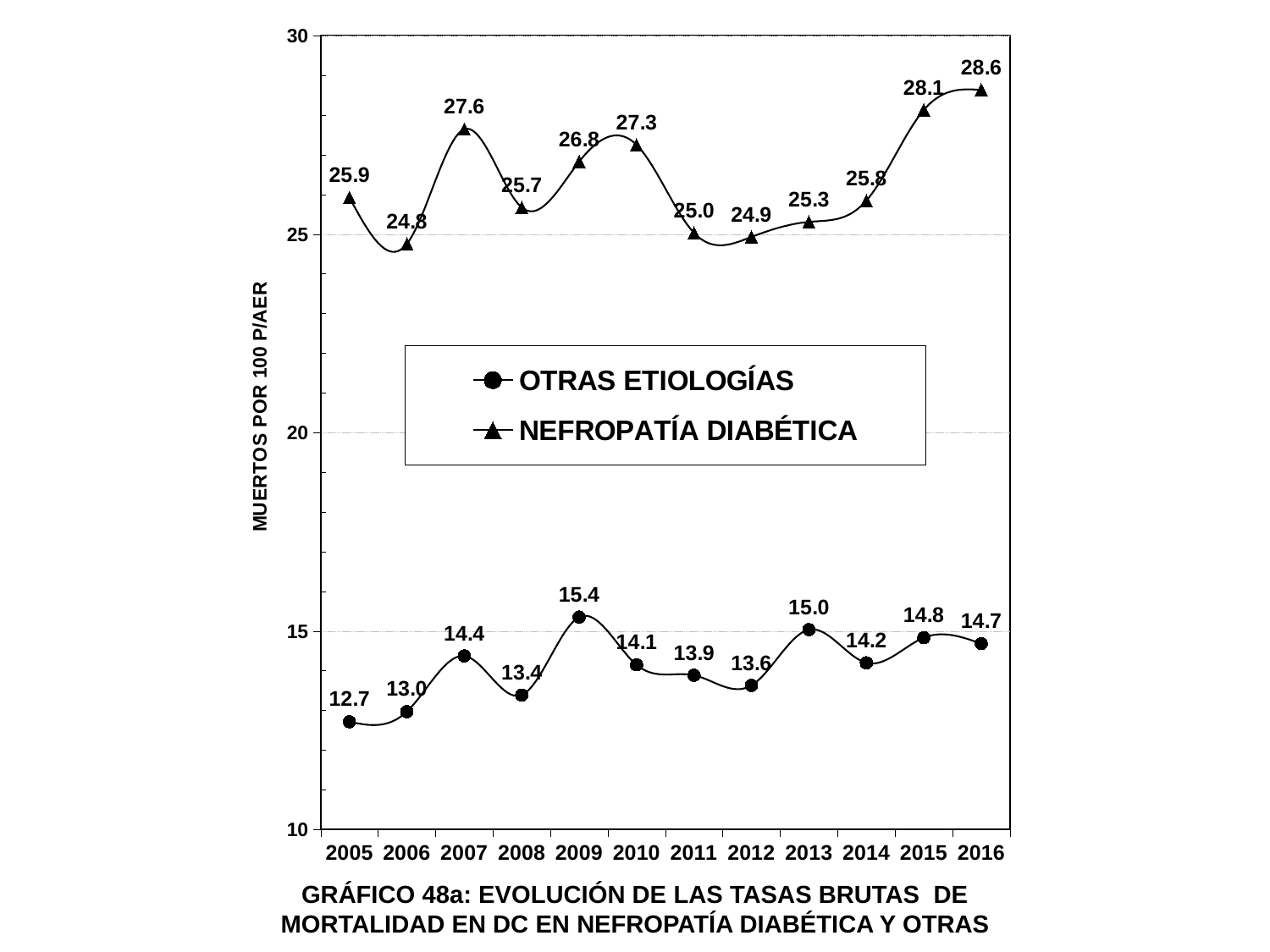
How many years are shown on the x axis? 12 In which year is the NEFROPATÍA DIABÉTICA series highest? 2016 In which year is the OTRAS ETIOLOGÍAS series lowest? 2005 What is the value for OTRAS ETIOLOGÍAS in 2012? 13.6 What kind of chart is this? line chart Which is larger for NEFROPATÍA DIABÉTICA: the value in 2009 or the value in 2010? 2010 Is the value for OTRAS ETIOLOGÍAS in 2009 greater or less than 15? greater What is the value for NEFROPATÍA DIABÉTICA in 2007? 27.6 What is the label of the y axis? MUERTOS POR 100 P/AER How many series does the legend list? 2 What is the difference between the NEFROPATÍA DIABÉTICA and OTRAS ETIOLOGÍAS values in 2016? 13.9 Does the NEFROPATÍA DIABÉTICA series rise or fall from 2012 to 2016? rise